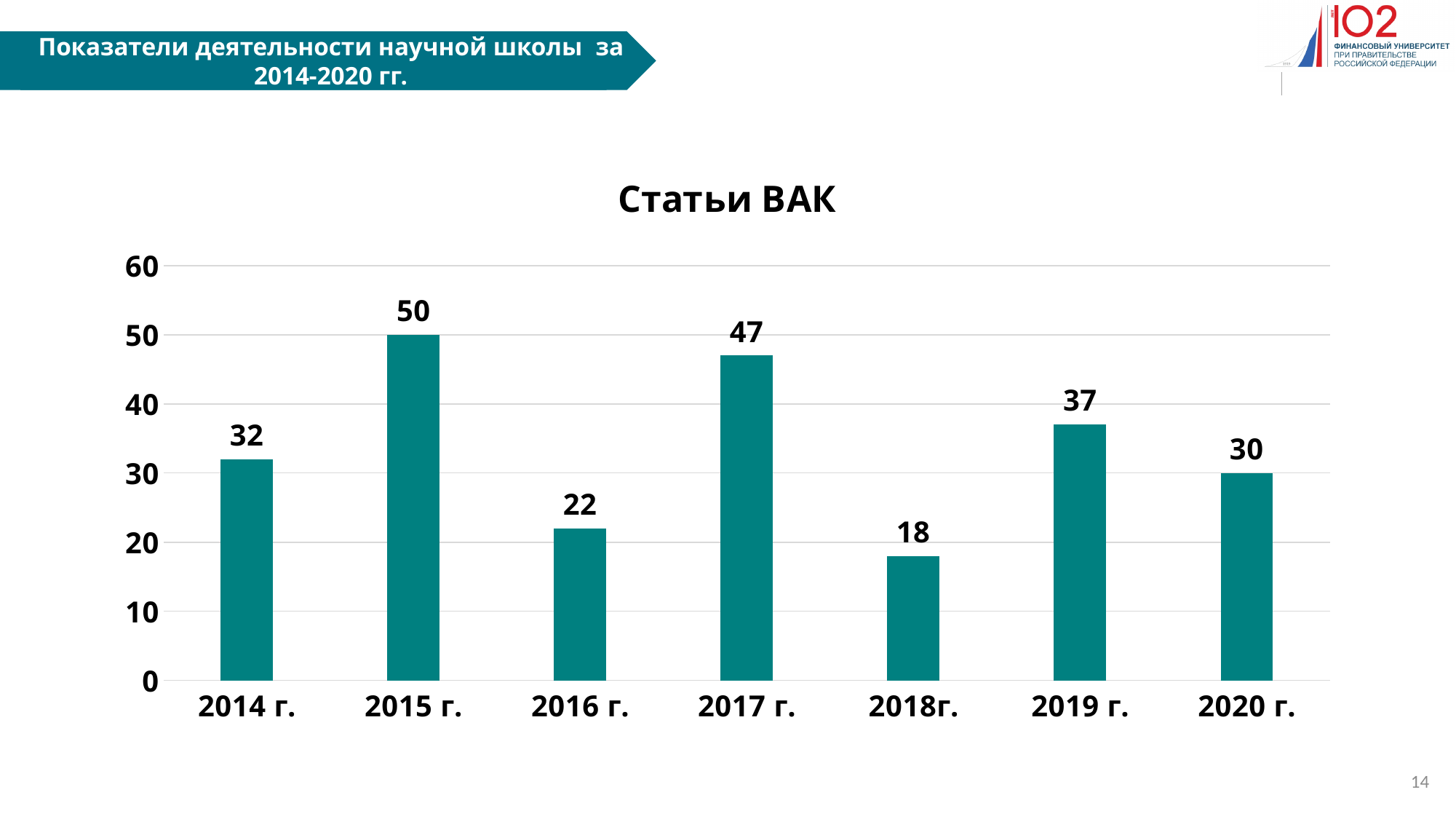
What is the value for 2015 г.? 50 Is the value for 2017 г. greater or less than 40? greater What kind of chart is shown on the slide? bar chart What is the value for 2020 г.? 30 Which year has the highest value? 2015 г. What is the difference between the values for 2017 г. and 2016 г.? 25 Which is larger, the value for 2014 г. or the value for 2019 г.? 2019 г. What is the value for 2018г.? 18 Which year has the lowest value? 2018г. What is the title of the chart? Статьи ВАК Do the values rise or fall from 2015 г. to 2016 г.? fall How many years are shown on the x axis? 7